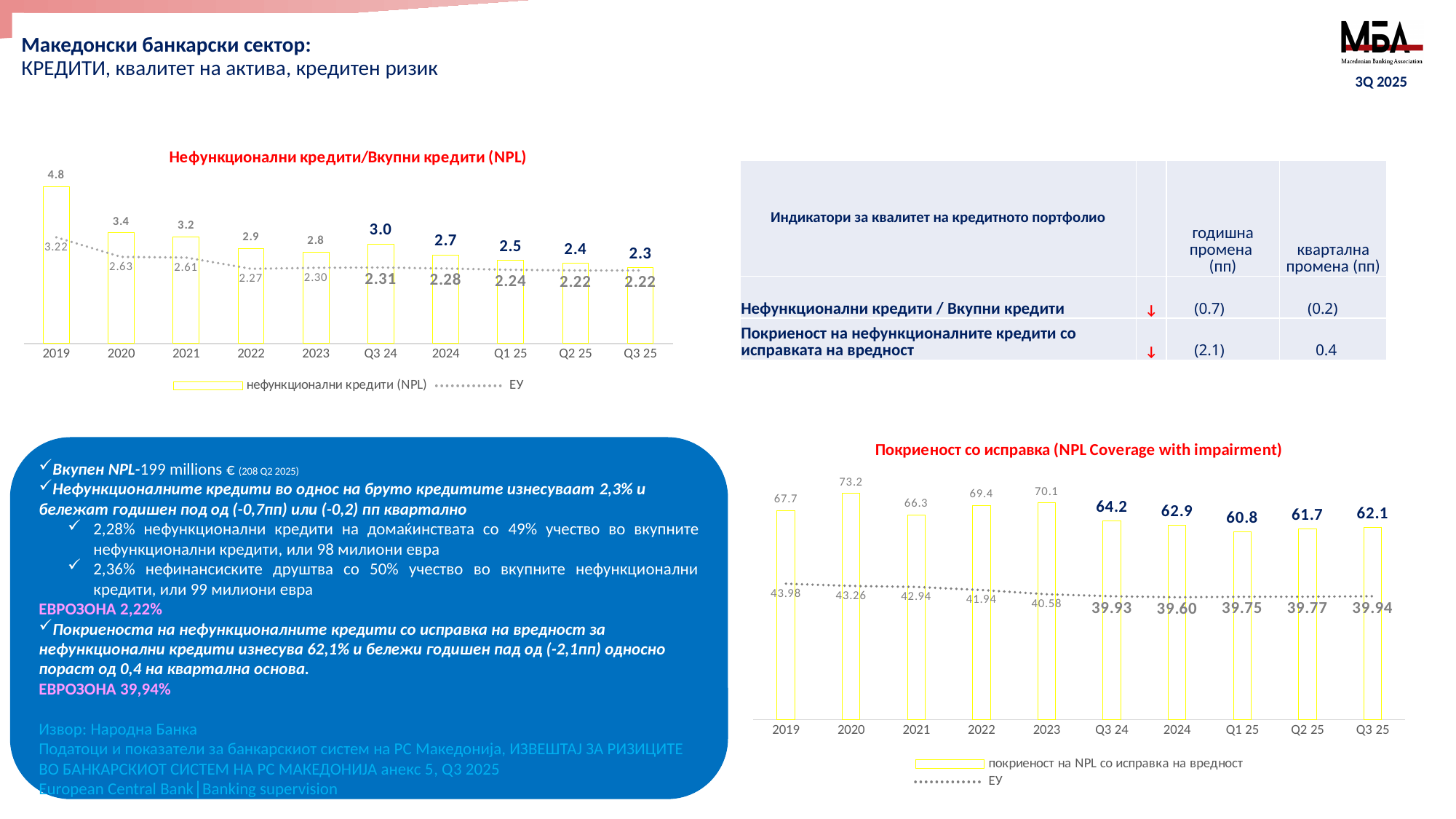
In the chart titled 'Покриеност со исправка (NPL Coverage with impairment)', how many series does the legend list? 2 In the chart titled 'Покриеност со исправка (NPL Coverage with impairment)', which period has the lowest coverage bar? Q1 25 In the chart titled 'Нефункционални кредити/Вкупни кредити (NPL)', what is the EU (ЕУ) value for Q3 25? 2.22 In the chart titled 'Нефункционални кредити/Вкупни кредити (NPL)', what is the NPL value for 2019? 4.8 In the chart titled 'Нефункционални кредити/Вкупни кредити (NPL)', do the NPL bar values generally rise or fall from 2019 to Q3 25? fall In the chart titled 'Нефункционални кредити/Вкупни кредити (NPL)', what is the difference between the NPL values for 2019 and 2020? 1.4 In the chart titled 'Покриеност со исправка (NPL Coverage with impairment)', is the coverage value for Q3 25 larger or the EU value for Q3 25? coverage value (62.1) In the chart titled 'Покриеност со исправка (NPL Coverage with impairment)', which period has the highest coverage bar? 2020 In the chart titled 'Нефункционални кредити/Вкупни кредити (NPL)', which period has the lowest NPL bar? Q3 25 In the chart titled 'Покриеност со исправка (NPL Coverage with impairment)', what is the EU (ЕУ) value for 2019? 43.98 In the chart titled 'Покриеност со исправка (NPL Coverage with impairment)', what is the coverage value for 2020? 73.2 In the chart titled 'Нефункционални кредити/Вкупни кредити (NPL)', how many periods are shown on the x axis? 10